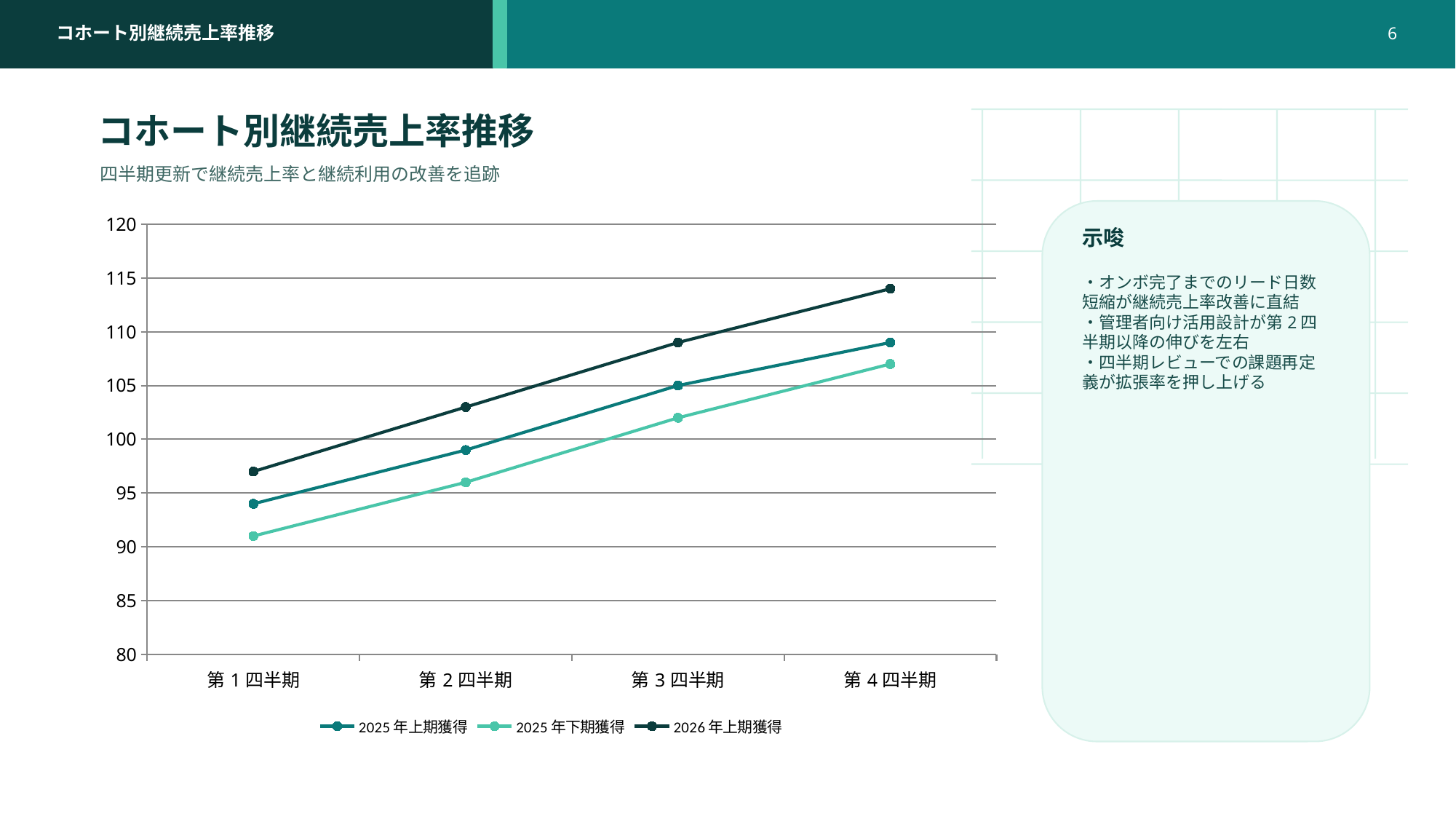
What is the title of the chart on the slide? コホート別継続売上率推移 How many quarters are shown on the x axis of the chart? 4 What kind of chart is shown on the slide? Line chart Is the value for 2026 年上期獲得 at 第 4 四半期 greater or less than 110? greater Is the value for 2025 年下期獲得 at 第 1 四半期 greater or less than 95? less Which series has the lowest value at 第 1 四半期? 2025 年下期獲得 How many series does the chart legend list? 3 At 第 2 四半期, which is larger: 2025 年上期獲得 or 2025 年下期獲得? 2025 年上期獲得 Is the value for 2026 年上期獲得 at 第 1 四半期 greater or less than 100? less Which series has the highest value at 第 4 四半期? 2026 年上期獲得 Do the values for 2025 年下期獲得 rise or fall from 第 1 四半期 to 第 4 四半期? Rise